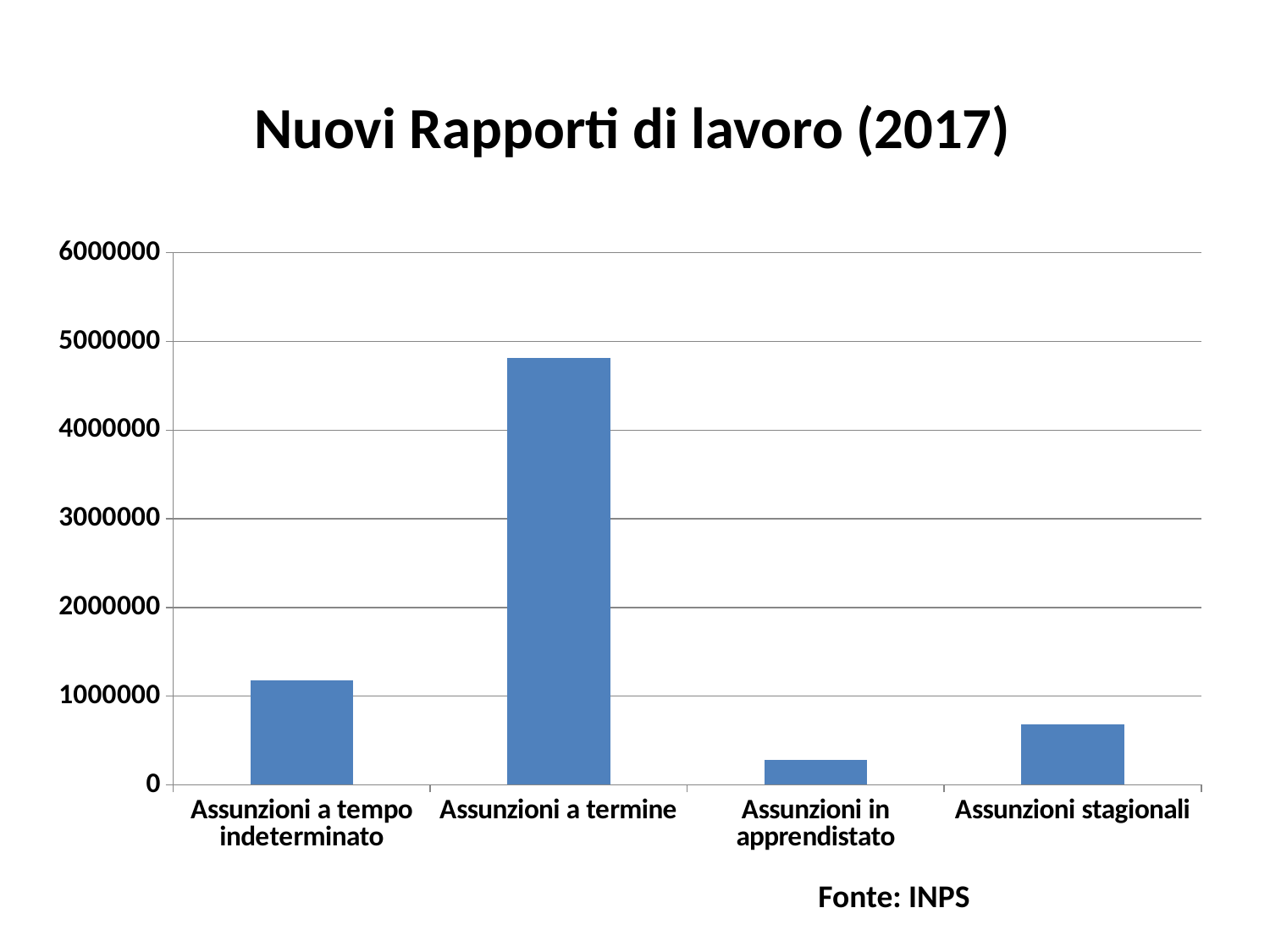
What type of chart is shown on the slide? bar chart Is the value for Assunzioni stagionali greater or less than 1000000? less What is the title of the chart? Nuovi Rapporti di lavoro (2017) Which category has the lowest value? Assunzioni in apprendistato Is the value for Assunzioni in apprendistato greater or less than 1000000? less Which is larger, the value for Assunzioni stagionali or the value for Assunzioni in apprendistato? Assunzioni stagionali Is the value for Assunzioni a tempo indeterminato greater or less than 1000000? greater Which category has the highest value? Assunzioni a termine Which is larger, the value for Assunzioni a tempo indeterminato or the value for Assunzioni stagionali? Assunzioni a tempo indeterminato How many categories are shown on the x axis? 4 What source is cited below the chart? Fonte: INPS